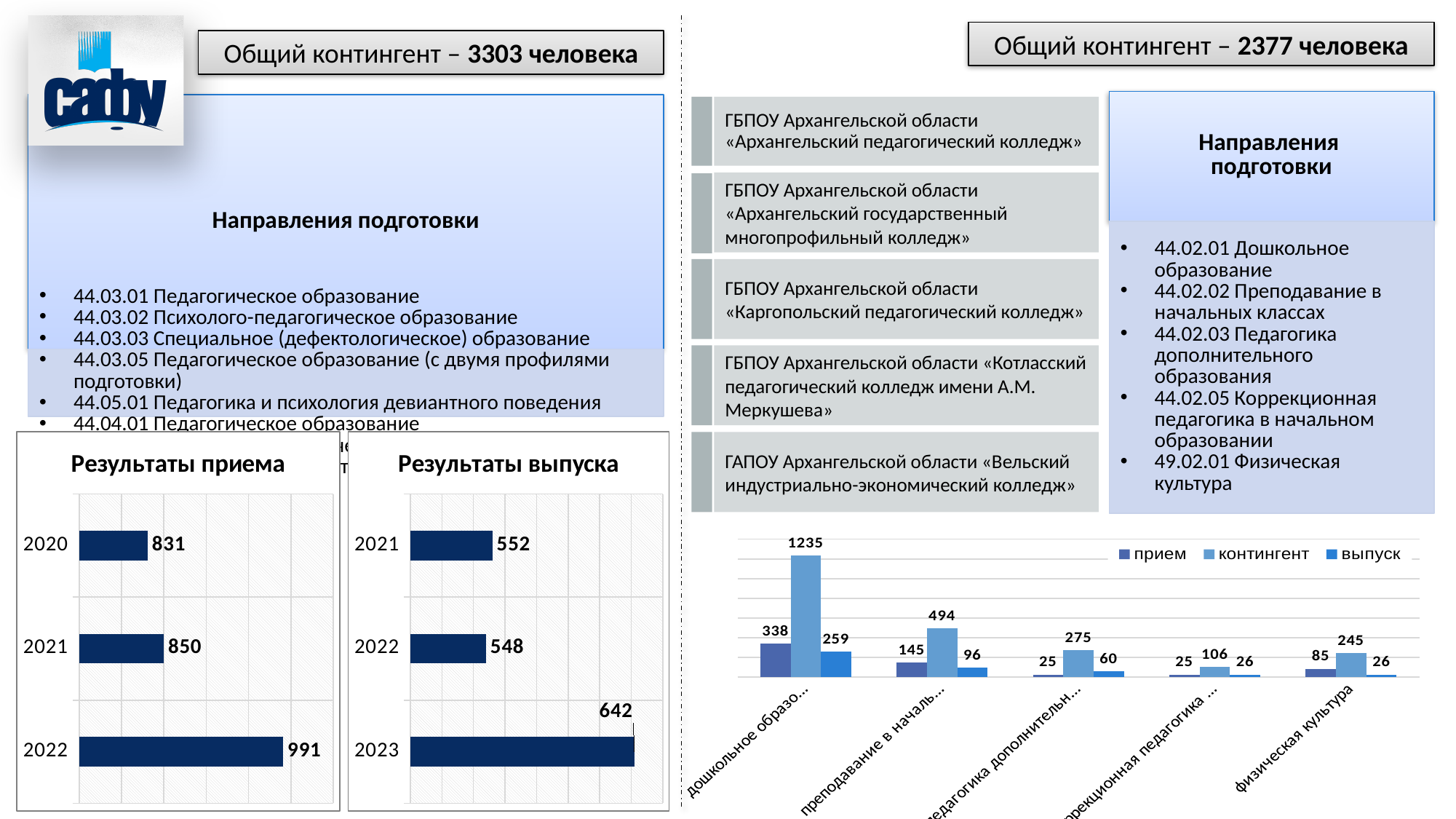
In the bottom-right grouped bar chart, what is the difference between the 'прием' and 'выпуск' values for 'физическая культура'? 59 In the 'Результаты приема' chart, do the values rise or fall from 2020 to 2022? rise In the 'Результаты выпуска' chart, what is the value for 2023? 642 In the 'Результаты выпуска' chart, how many years are shown? 3 In the bottom-right grouped bar chart, which category has the highest 'контингент' value? дошкольное образование (the first category) In the bottom-right grouped bar chart, what is the 'контингент' value for 'физическая культура'? 245 In the 'Результаты приема' chart, what is the difference between the values for 2022 and 2021? 141 What kind of chart is 'Результаты выпуска'? bar chart In the 'Результаты выпуска' chart, which is larger, the value for 2021 or 2022? 2021 In the 'Результаты приема' chart, what is the value for 2022? 991 In the 'Результаты приема' chart, which year has the lowest value? 2020 In the bottom-right grouped bar chart, how many series does the legend list? 3